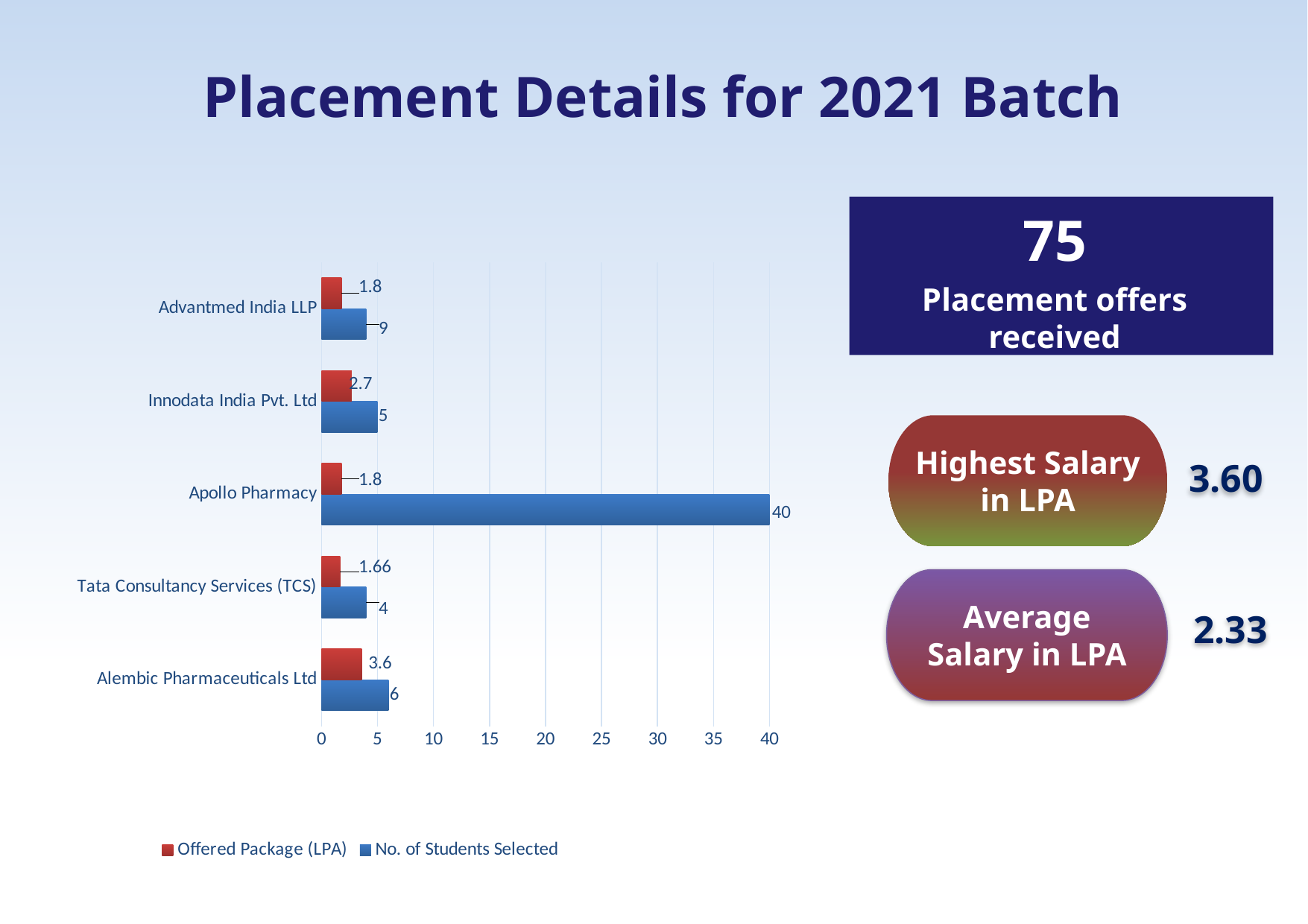
How many students were selected by Apollo Pharmacy? 40 What is the difference in the number of students selected between Apollo Pharmacy and Innodata India Pvt. Ltd? 35 What is the offered package (LPA) for Alembic Pharmaceuticals Ltd? 3.6 Which company selected the highest number of students? Apollo Pharmacy How many series does the chart legend list? 2 How many companies are shown in the chart? 5 What is the offered package (LPA) for Tata Consultancy Services (TCS)? 1.66 What kind of chart is shown on the slide? Bar chart Which company has the lowest offered package (LPA)? Tata Consultancy Services (TCS) How many students were selected by Advantmed India LLP? 9 Which company has a higher offered package (LPA): Innodata India Pvt. Ltd or Advantmed India LLP? Innodata India Pvt. Ltd Which colour represents the 'No. of Students Selected' series in the chart? Blue